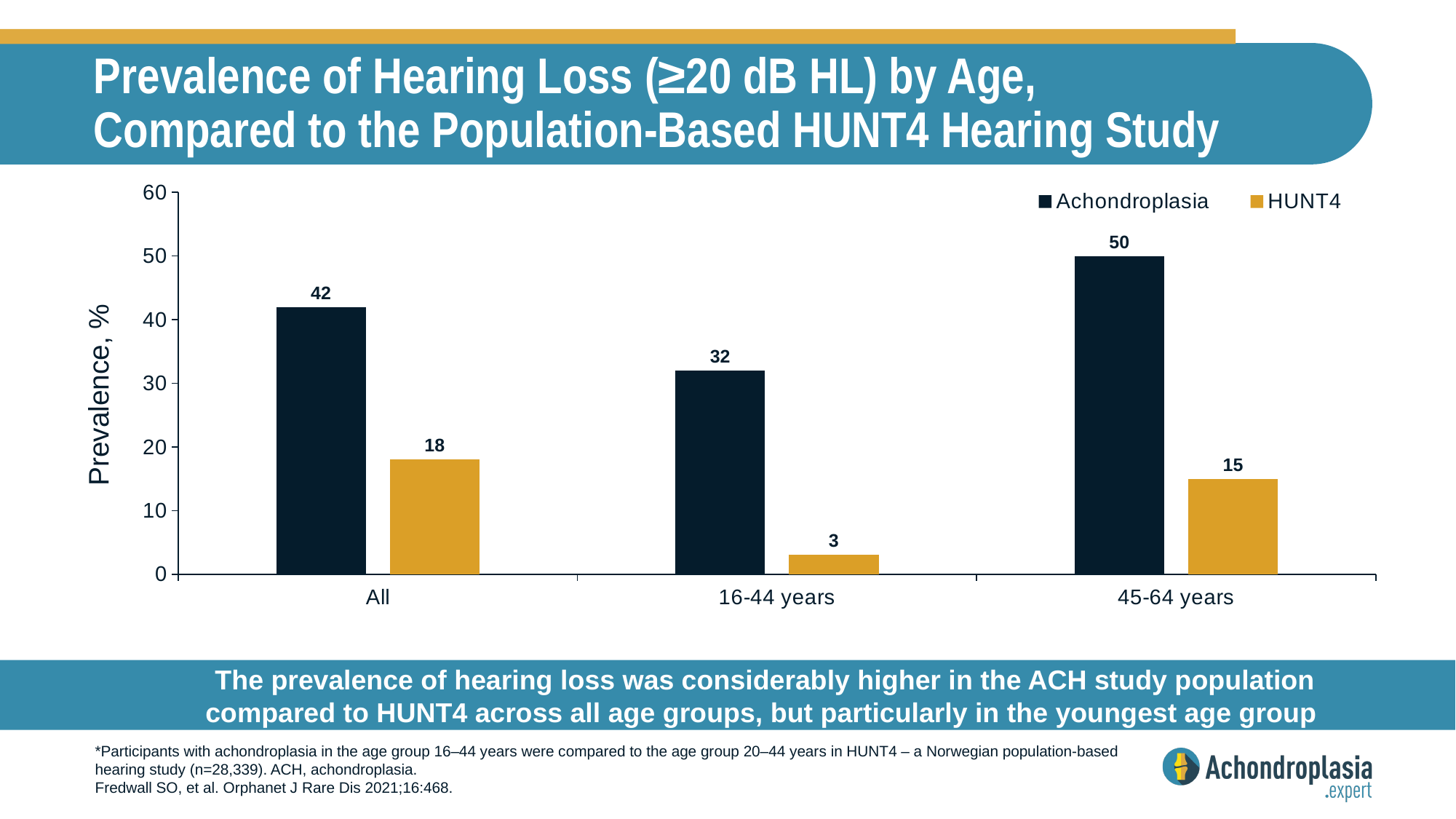
What kind of chart is shown on the slide? Bar chart Which is larger in the 45-64 years group, Achondroplasia or HUNT4? Achondroplasia What is the difference between the Achondroplasia and HUNT4 values in the 16-44 years group? 29 What is the difference between the Achondroplasia and HUNT4 values in the All group? 24 Which age group has the highest Achondroplasia prevalence? 45-64 years What is the label of the y axis? Prevalence, % How many age groups are shown on the x axis? 3 How many series does the legend list? 2 What is the prevalence of hearing loss for Achondroplasia in the All group? 42 What is the prevalence of hearing loss for HUNT4 in the 16-44 years group? 3 What is the prevalence of hearing loss for HUNT4 in the 45-64 years group? 15 Which age group has the lowest HUNT4 prevalence? 16-44 years